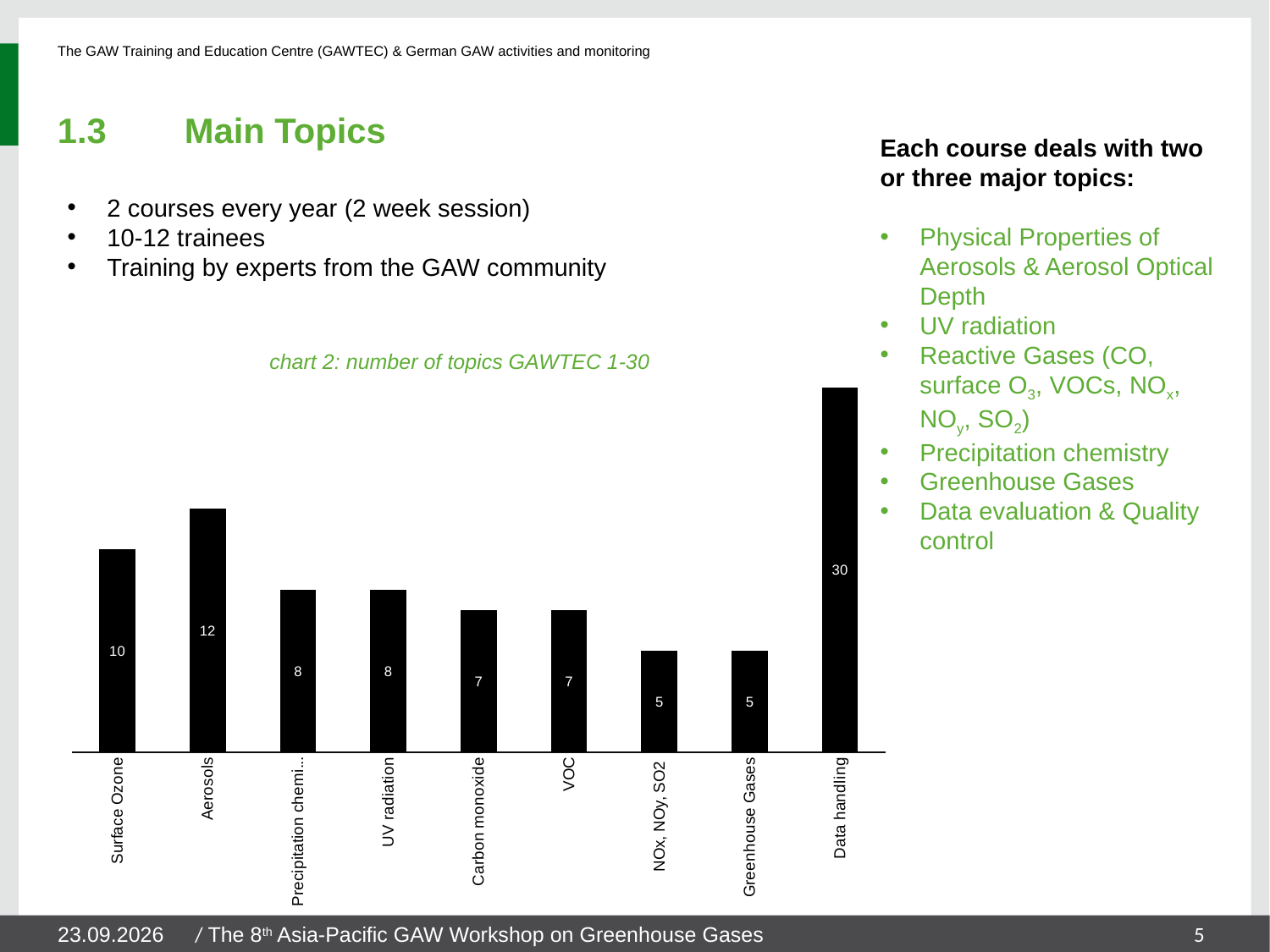
What is the difference between the values for Data handling and Surface Ozone? 20 What is the value for Data handling? 30 What is the value for Carbon monoxide? 7 How many categories are shown in the chart? 9 What is the value for Greenhouse Gases? 5 What kind of chart is shown on the slide? bar chart Which category has the highest value? Data handling What is the difference between the values for Aerosols and UV radiation? 4 What colour are the bars in the chart? black What is the value for Aerosols? 12 What is the title of the chart? chart 2: number of topics GAWTEC 1-30 Which is larger, the value for Surface Ozone or the value for VOC? Surface Ozone